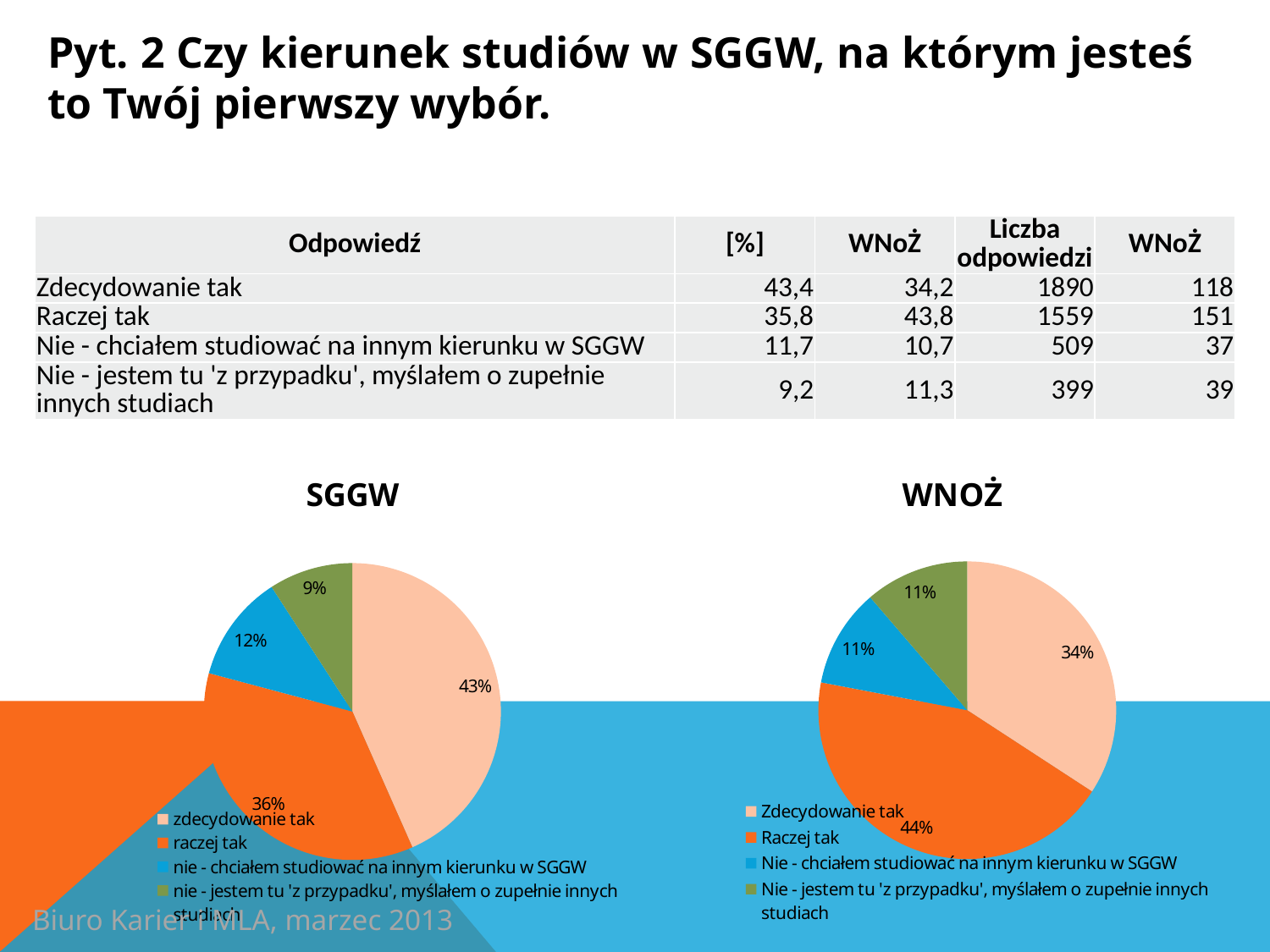
How many slices does the WNOŻ pie chart have? 4 In the WNOŻ pie chart, what is the difference between the 'Raczej tak' and 'Zdecydowanie tak' shares? 10% In the SGGW pie chart, what share is shown for 'zdecydowanie tak'? 43% In the SGGW pie chart, which is larger: 'zdecydowanie tak' or 'raczej tak'? zdecydowanie tak What kind of chart is the SGGW chart? pie chart In the SGGW pie chart, what share is shown for 'nie - chciałem studiować na innym kierunku w SGGW'? 12% How many entries does the legend of the SGGW pie chart list? 4 In the WNOŻ pie chart, what share is shown for 'Raczej tak'? 44% In the WNOŻ pie chart, which category has the largest slice? Raczej tak In the SGGW pie chart, which category has the smallest slice? nie - jestem tu 'z przypadku', myślałem o zupełnie innych studiach